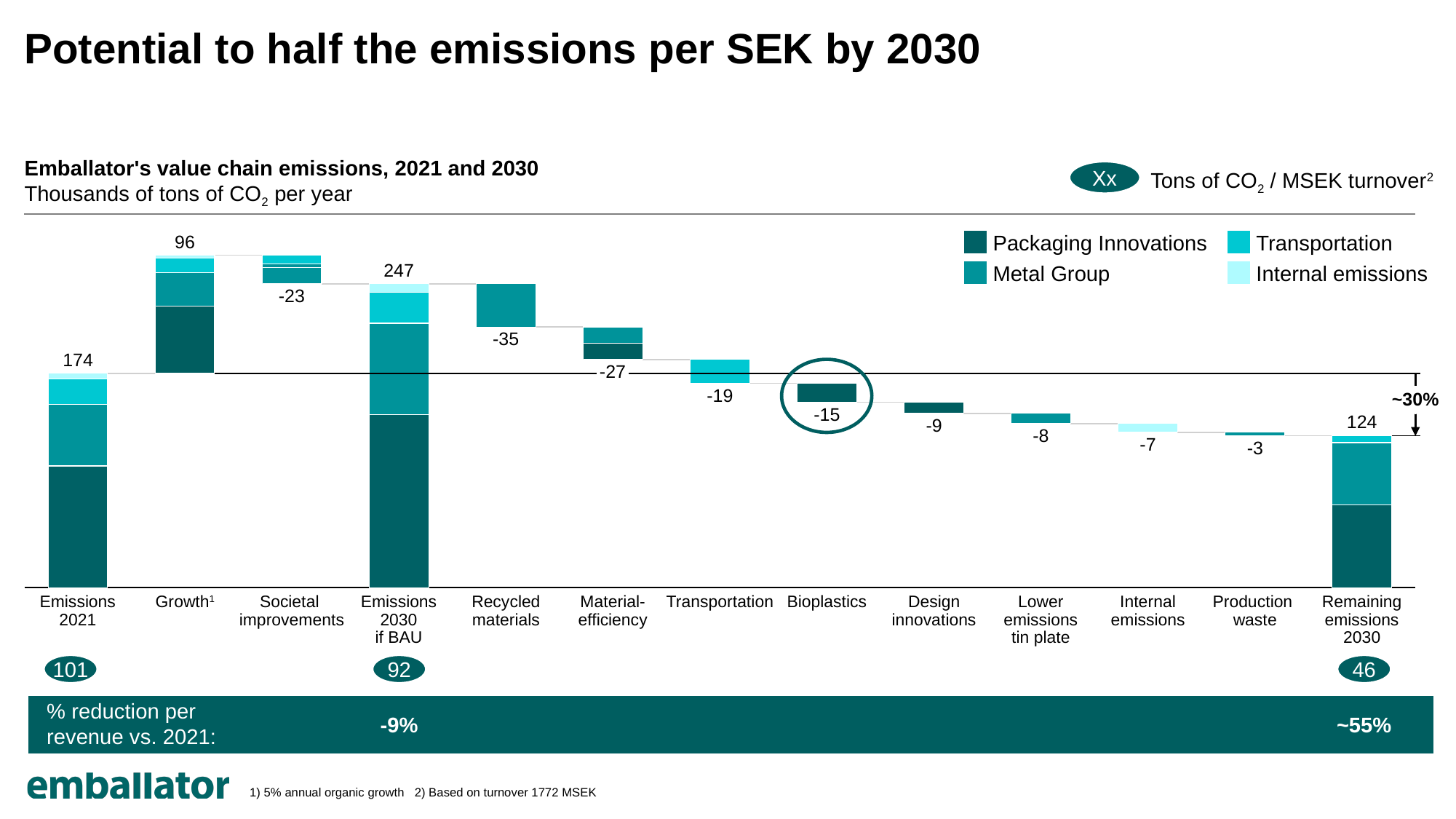
How many series does the legend list? 4 What kind of chart is shown on the slide? bar chart What is the value shown for Recycled materials? -35 What is the Tons of CO2 / MSEK turnover figure shown below Remaining emissions 2030? 46 Which has the larger reduction, Transportation or Bioplastics? Transportation What is the value for Remaining emissions 2030? 124 What is the value for Emissions 2030 if BAU? 247 Which reduction lever between Emissions 2030 if BAU and Remaining emissions 2030 has the largest reduction? Recycled materials What is the difference between Emissions 2030 if BAU and Remaining emissions 2030? 123 Which reduction lever between Emissions 2030 if BAU and Remaining emissions 2030 has the smallest reduction? Production waste How many categories are shown on the x axis? 13 What is the value for Emissions 2021? 174